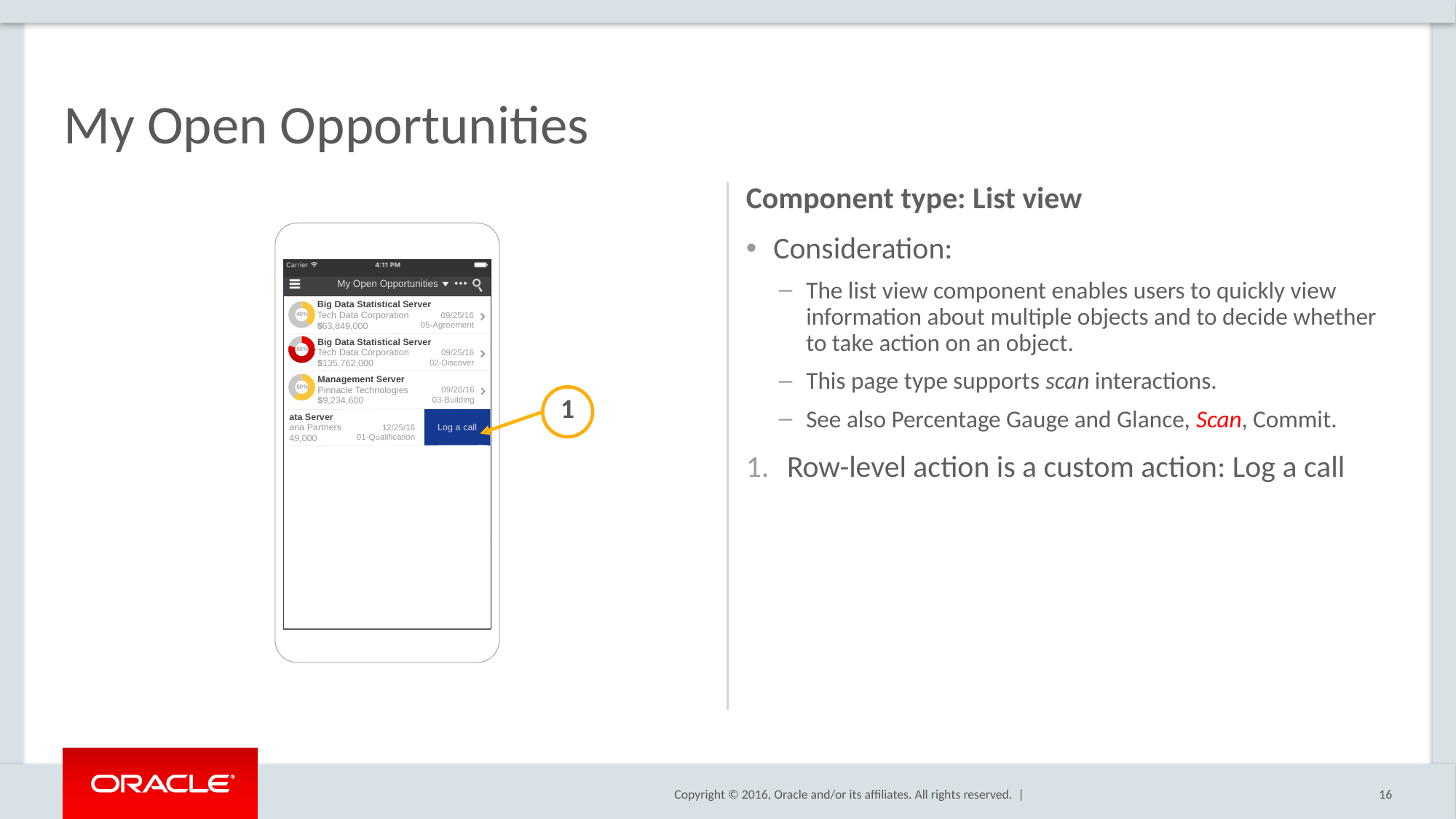
What kind of chart is shown next to each row in the My Open Opportunities list on the phone mockup? Percentage gauge (donut chart) What is the title shown in the header bar of the phone mockup list? My Open Opportunities Which row's gauge is filled more: the first Big Data Statistical Server row (40%) or the Management Server row (60%)? Management Server What percentage does the gauge for the Management Server row show? 60% Which gauge in the list is shown in red rather than yellow? The second Big Data Statistical Server row (02-Discover) What is the dollar amount shown for the second Big Data Statistical Server row (02-Discover)? $135,762,000 How many percentage gauges are visible in the list on the phone mockup? 3 What is the difference between the Management Server gauge (60%) and the first Big Data Statistical Server gauge (40%)? 20% What is the dollar amount shown for the Management Server row? $9,234,600 What percentage does the gauge for the first Big Data Statistical Server row (05-Agreement) show? 40%